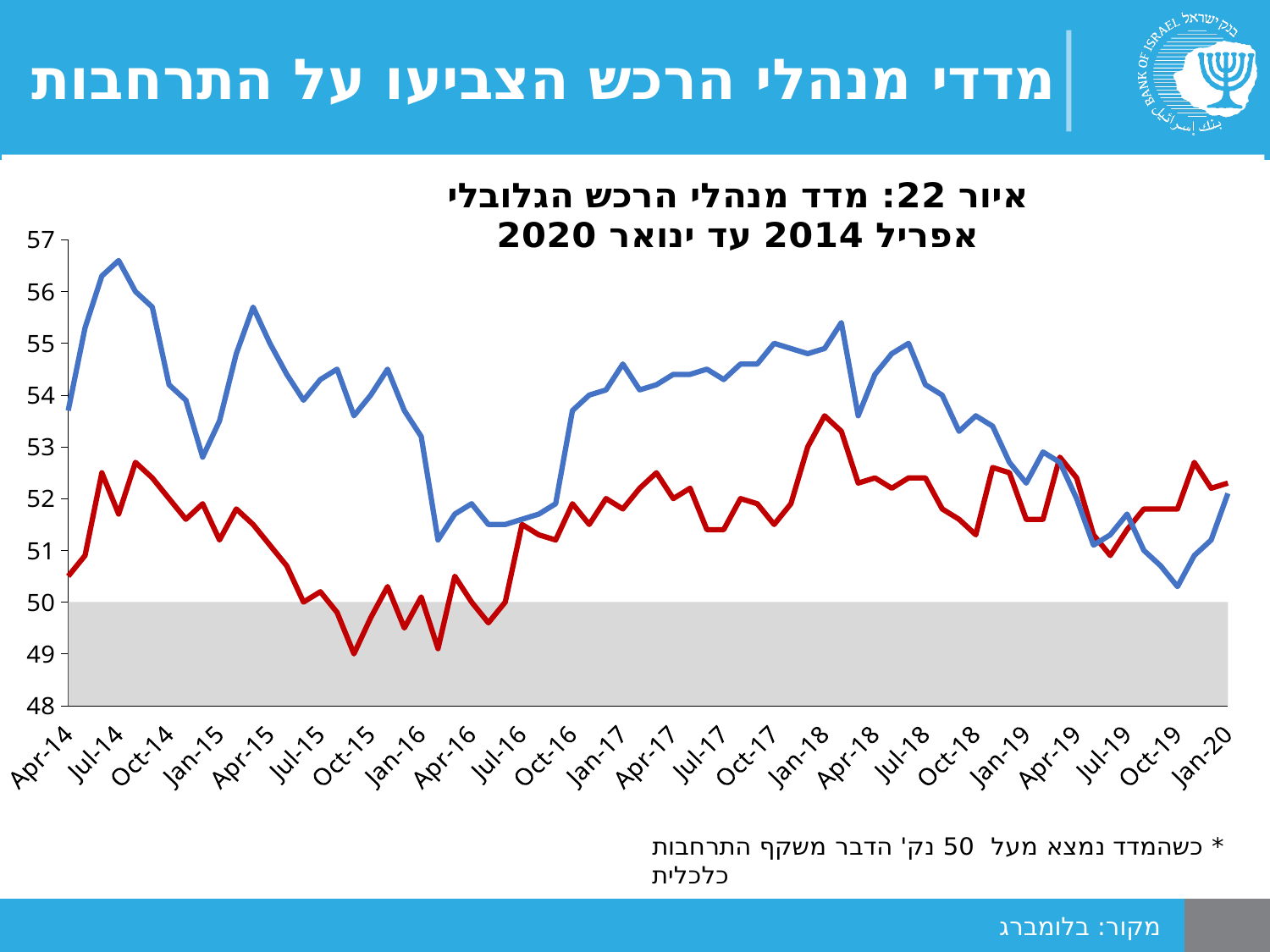
What is the first date label on the x axis? Apr-14 At Oct-19, which line has the higher value, the blue line or the red line? red line Is the value of the blue line at Oct-19 greater or less than 51? less How many date labels are shown along the x axis? 24 Is the value of the red line at Oct-15 greater or less than 50? less At Jul-14, which line has the higher value, the blue line or the red line? blue line Is the value of the blue line at Jul-14 greater or less than 55? greater What kind of chart is shown on the slide? line chart How many lines are plotted on the chart? 2 Does the blue line rise or fall between Jan-18 and Oct-19? fall What is the last date label on the x axis? Jan-20